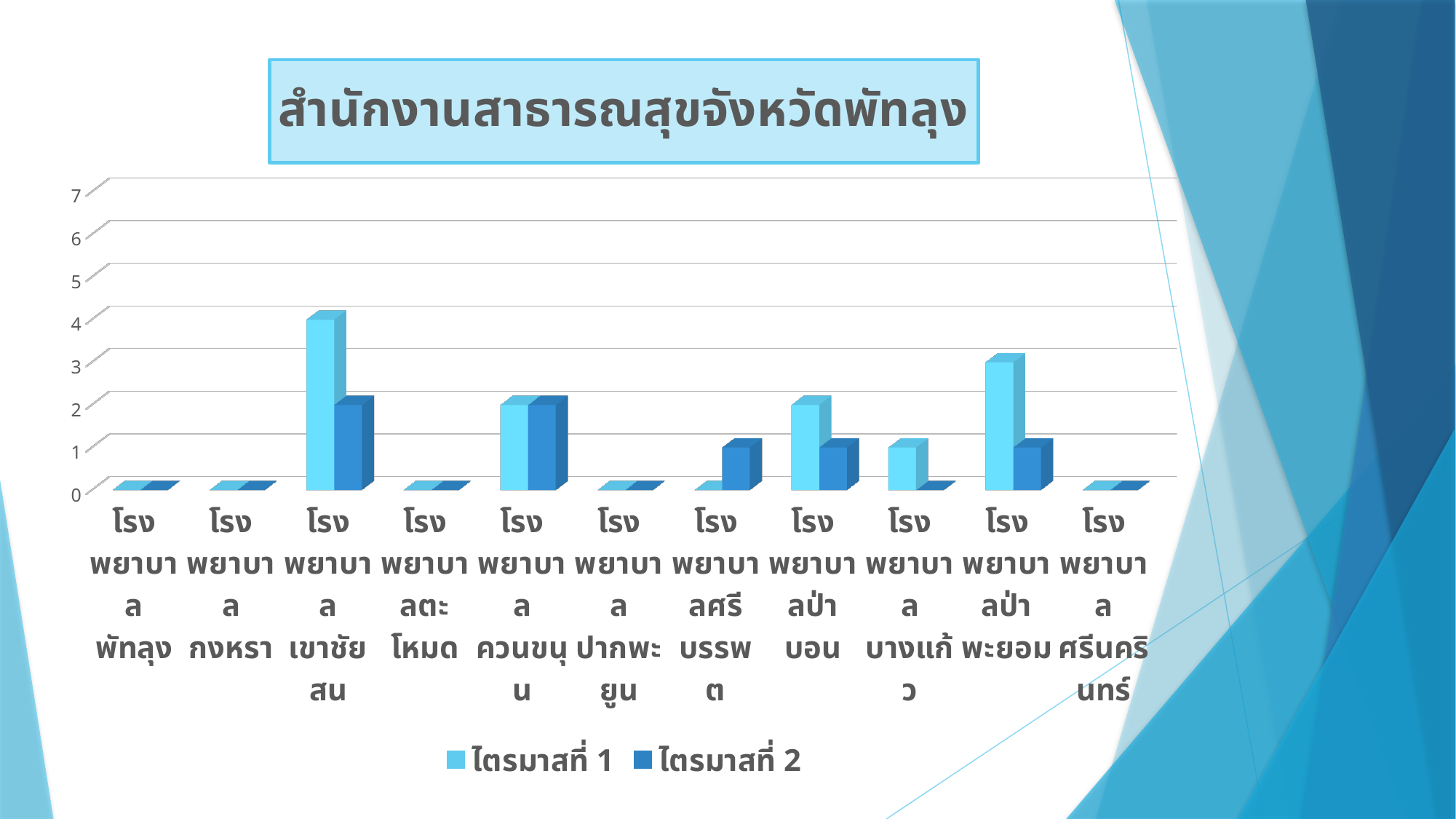
Which hospital has the highest value in ไตรมาสที่ 1? โรงพยาบาลเขาชัยสน What is the value for โรงพยาบาลเขาชัยสน in ไตรมาสที่ 1? 4 What is the title of the chart? สำนักงานสาธารณสุขจังหวัดพัทลุง What type of chart is shown on the slide? bar chart How many series does the legend list? 2 What is the value for โรงพยาบาลป่าพะยอม in ไตรมาสที่ 1? 3 Which is larger for โรงพยาบาลป่าบอน: the ไตรมาสที่ 1 value or the ไตรมาสที่ 2 value? ไตรมาสที่ 1 What is the difference between the ไตรมาสที่ 1 and ไตรมาสที่ 2 values for โรงพยาบาลเขาชัยสน? 2 What are the two legend entries of the chart? ไตรมาสที่ 1 and ไตรมาสที่ 2 How many hospitals (categories) are shown on the x axis? 11 What is the value for โรงพยาบาลศรีบรรพต in ไตรมาสที่ 2? 1 Is the ไตรมาสที่ 1 value for โรงพยาบาลเขาชัยสน greater or less than 3? greater